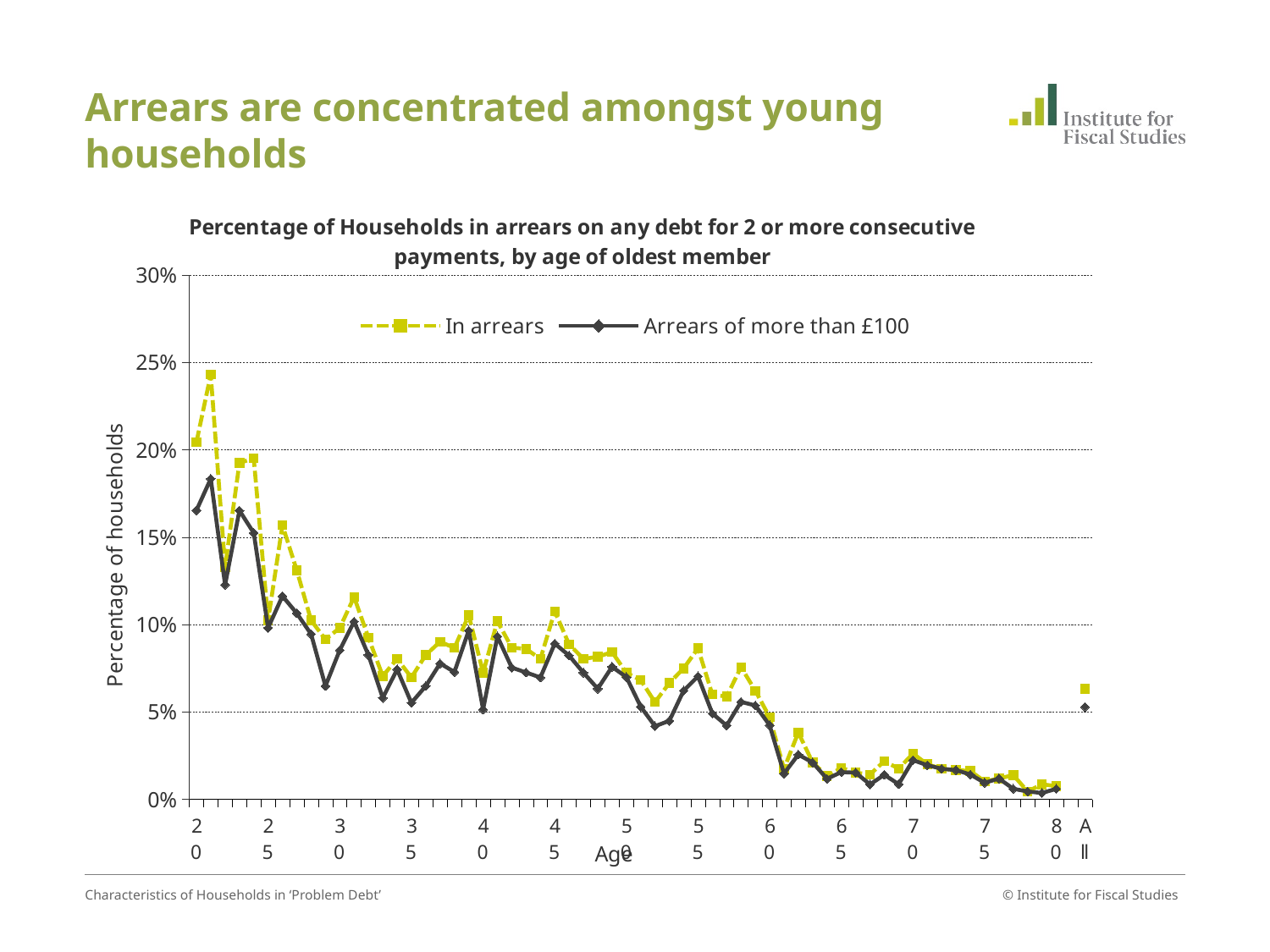
Is the value for 'Arrears of more than £100' at age 20 greater or less than 15%? greater Is the value for 'In arrears' at age 30 greater or less than 5%? greater Is the highest value for 'In arrears' found at the young end or the old end of the age range? Young end What is the title of the chart? Percentage of Households in arrears on any debt for 2 or more consecutive payments, by age of oldest member How many series does the legend list? 2 What kind of chart is shown on the slide? Line chart What are the two series named in the legend? In arrears; Arrears of more than £100 Do the values for 'In arrears' generally rise or fall as age increases along the x axis? Fall Is the value for 'In arrears' for the 'All' category greater or less than 5%? greater